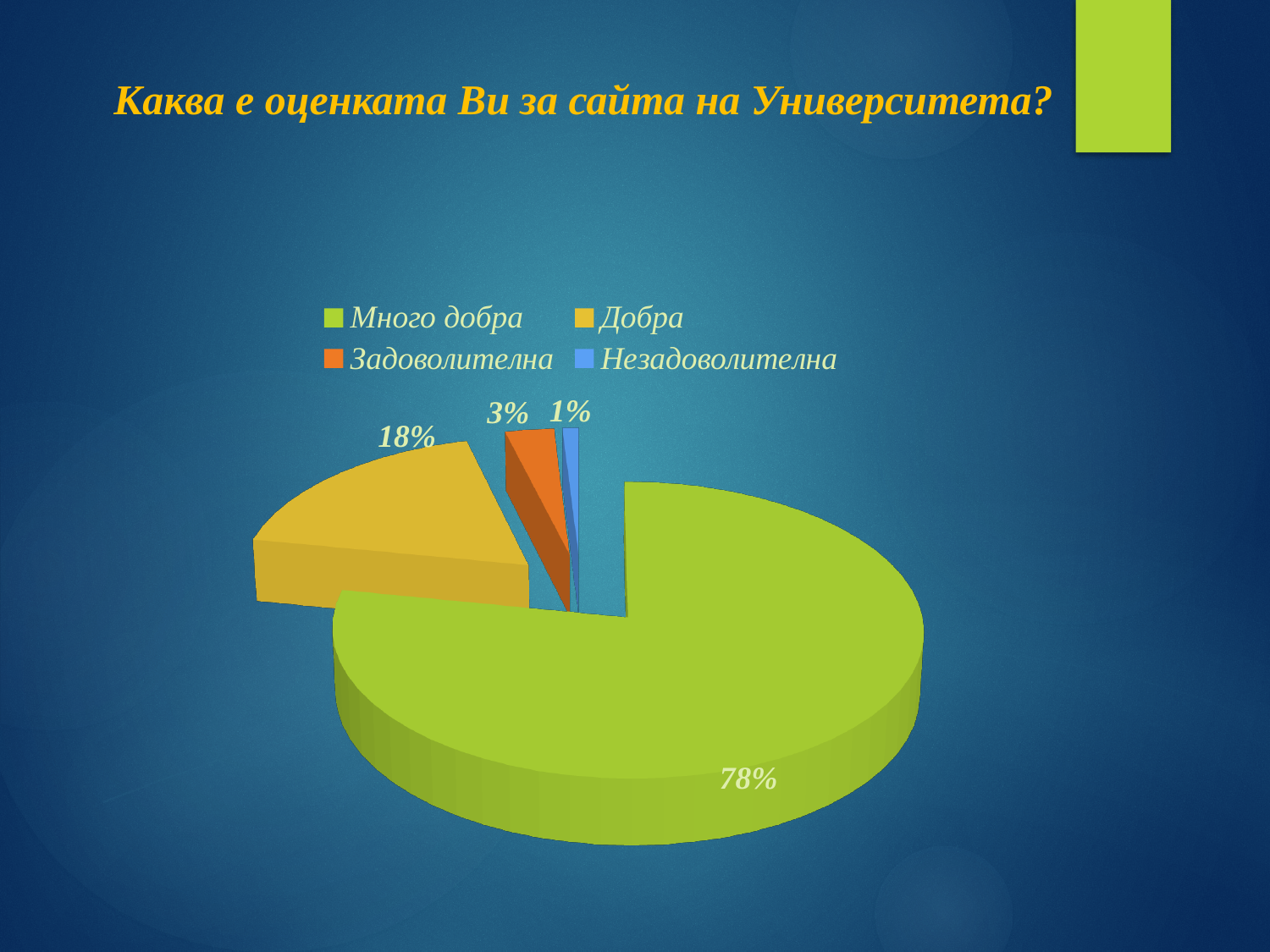
What share of the pie does "Незадоволителна" have? 1% What share of the pie does "Задоволителна" have? 3% Which category has the smallest slice of the pie? Незадоволителна What share of the pie does "Добра" have? 18% Which is larger, the slice for "Добра" or the slice for "Задоволителна"? Добра What colour is the slice for "Задоволителна"? Orange How many categories does the pie chart show? 4 Which category has the largest slice of the pie? Много добра What is the title of the slide above the chart? Каква е оценката Ви за сайта на Университета? What kind of chart is shown on the slide? Pie chart What is the difference in percentage points between "Много добра" and "Добра"? 60